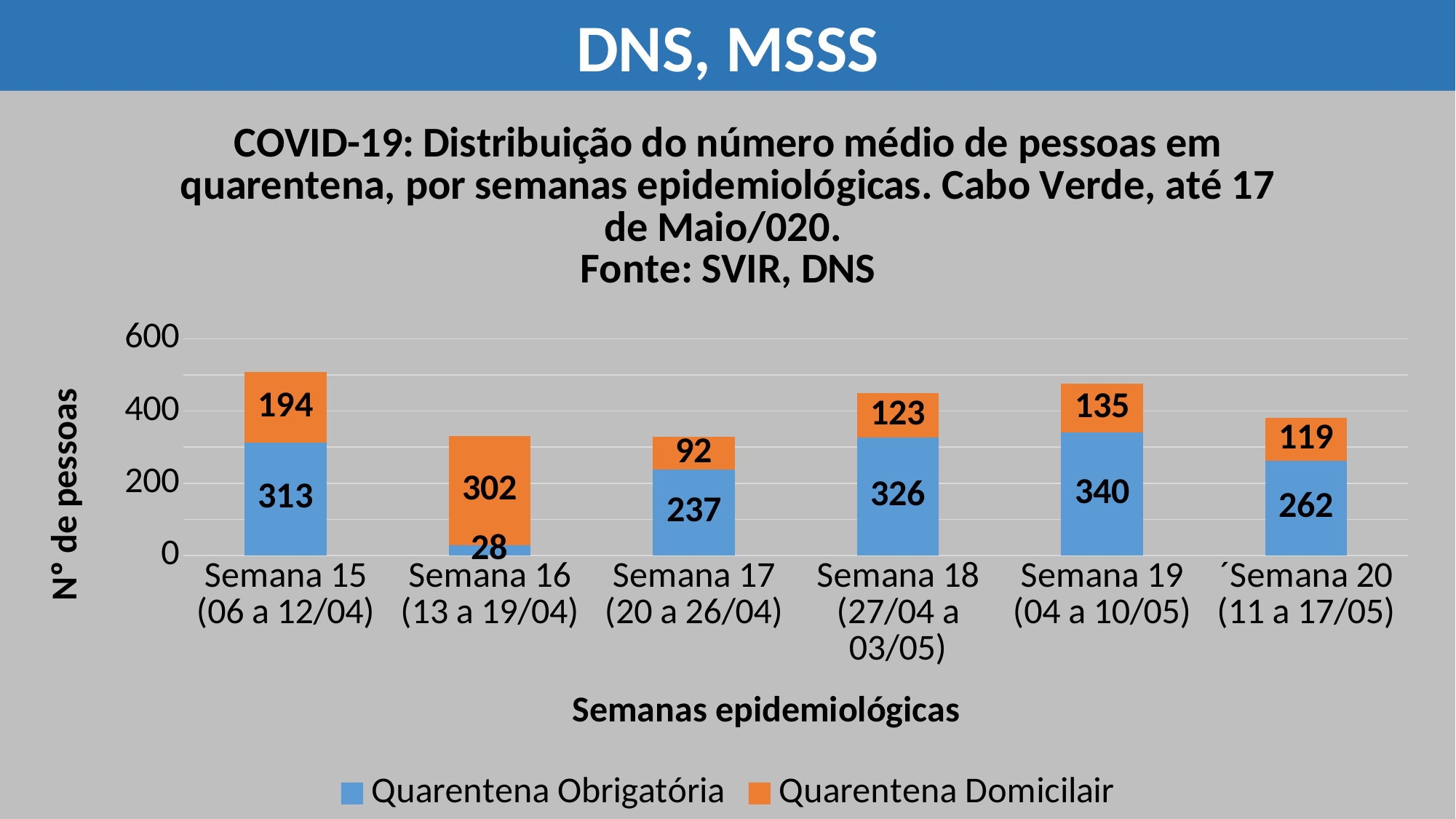
What is the total of the stacked bar for Semana 18 (27/04 a 03/05)? 449 What is the total of the stacked bar for Semana 15 (06 a 12/04)? 507 What is the difference between Quarentena Obrigatória in Semana 19 and Semana 18? 14 What is the value for Quarentena Domicilair in Semana 20 (11 a 17/05)? 119 Which week has the highest value for Quarentena Obrigatória? Semana 19 (04 a 10/05) Which week has the lowest value for Quarentena Domicilair? Semana 17 (20 a 26/04) Which week has the lowest value for Quarentena Obrigatória? Semana 16 (13 a 19/04) How many series does the legend list? 2 What is the value for Quarentena Domicilair in Semana 16 (13 a 19/04)? 302 Which is larger: Quarentena Domicilair in Semana 15 or in Semana 19? Semana 15 What is the value for Quarentena Obrigatória in Semana 15 (06 a 12/04)? 313 How many weeks (categories) are shown on the x axis? 6